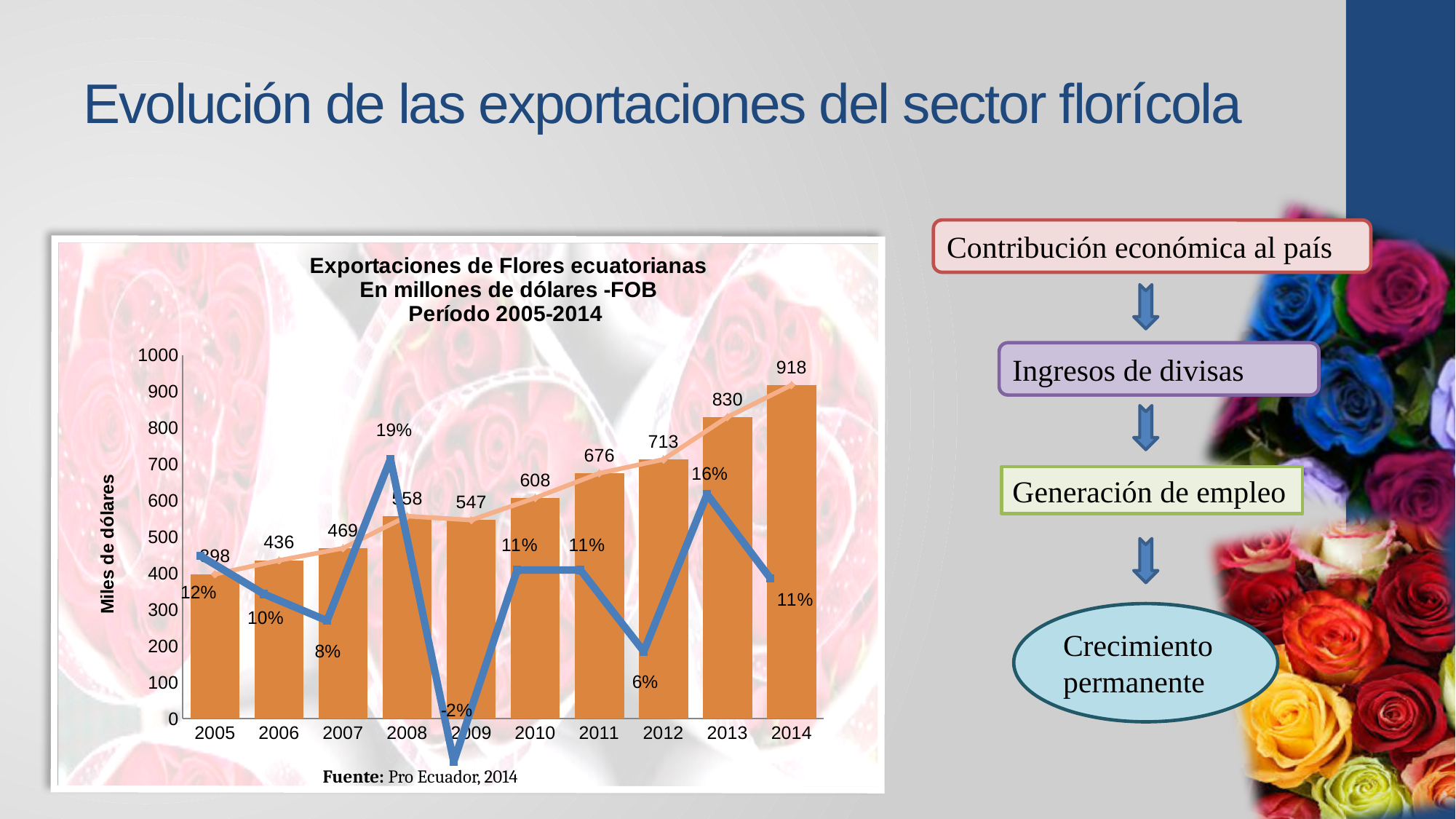
Which is larger, the export value for 2008 or for 2009? 2008 What growth percentage is shown for 2009? -2% How many years are shown on the x axis? 10 What is the export value shown for 2014? 918 Which year has the lowest export value? 2005 What kind of chart is used to show the export values? Bar chart Do the export values generally rise or fall from 2005 to 2014? Rise What growth percentage is shown for 2008? 19% Which year has the highest export value? 2014 What is the difference between the export values for 2014 and 2013? 88 What is the export value shown for 2009? 547 What is the source cited below the chart? Pro Ecuador, 2014